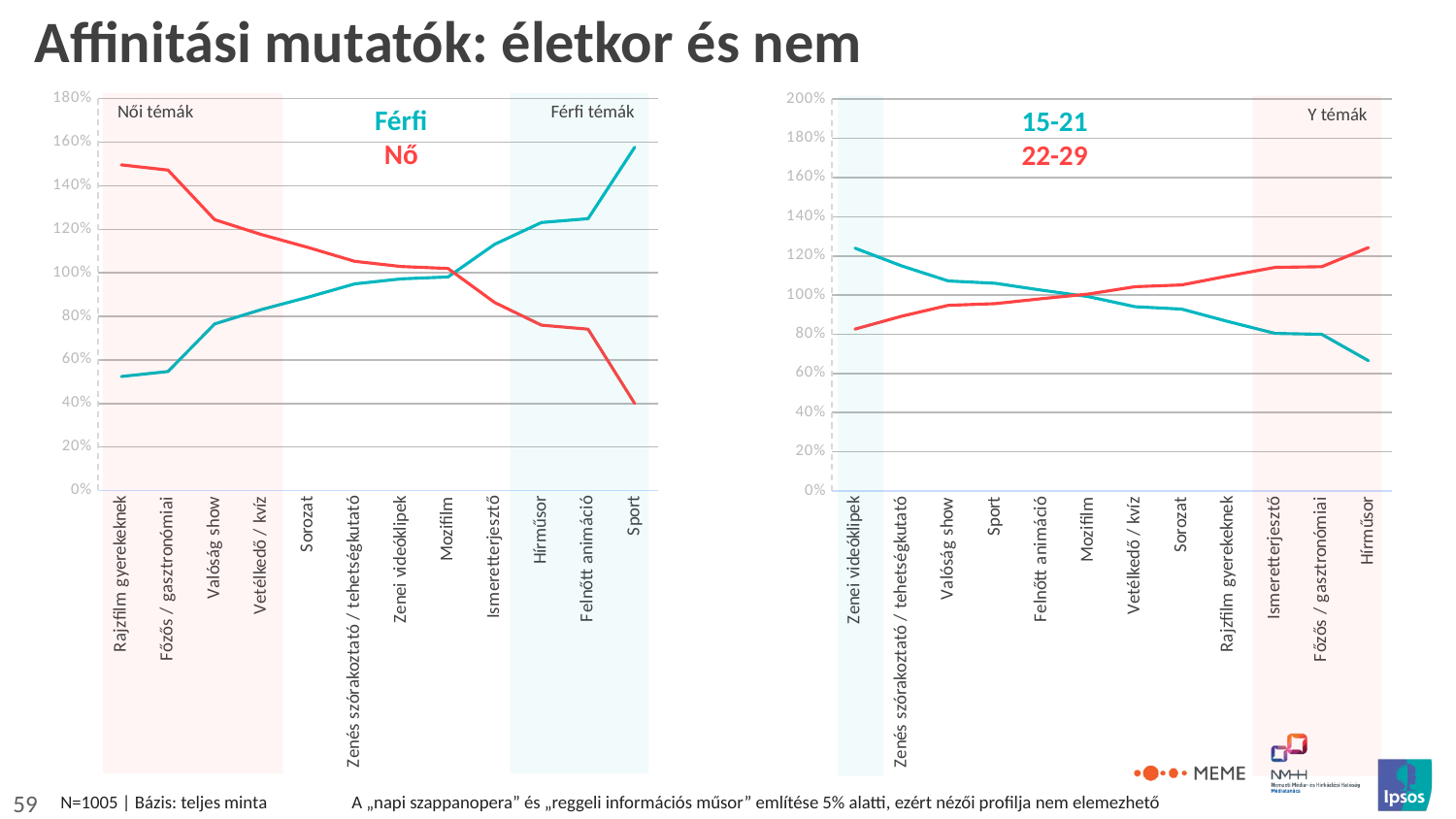
In the left chart (Férfi / Nő), which category has the highest value for the Nő series? Rajzfilm gyerekeknek In the left chart (Férfi / Nő), which series has the larger value for Sport, Férfi or Nő? Férfi In the right chart (15-21 / 22-29), does the 15-21 series generally rise or fall from left to right along the x axis? fall In the right chart (15-21 / 22-29), what label is shown on the shaded region at the right side of the chart? Y témák In the right chart (15-21 / 22-29), which category has the lowest value for the 15-21 series? Hírműsor In the right chart (15-21 / 22-29), is the 15-21 value for Hírműsor greater or less than 80%? less In the left chart (Férfi / Nő), which category has the highest value for the Férfi series? Sport How many categories are on the x axis of the left chart (Férfi / Nő)? 12 What kind of chart is the left chart (Férfi / Nő)? line chart How many series does the right chart (15-21 / 22-29) show? 2 In the left chart (Férfi / Nő), is the Nő value for Rajzfilm gyerekeknek greater or less than 140%? greater In the right chart (15-21 / 22-29), is the 22-29 value for Zenei videóklipek greater or less than 100%? less